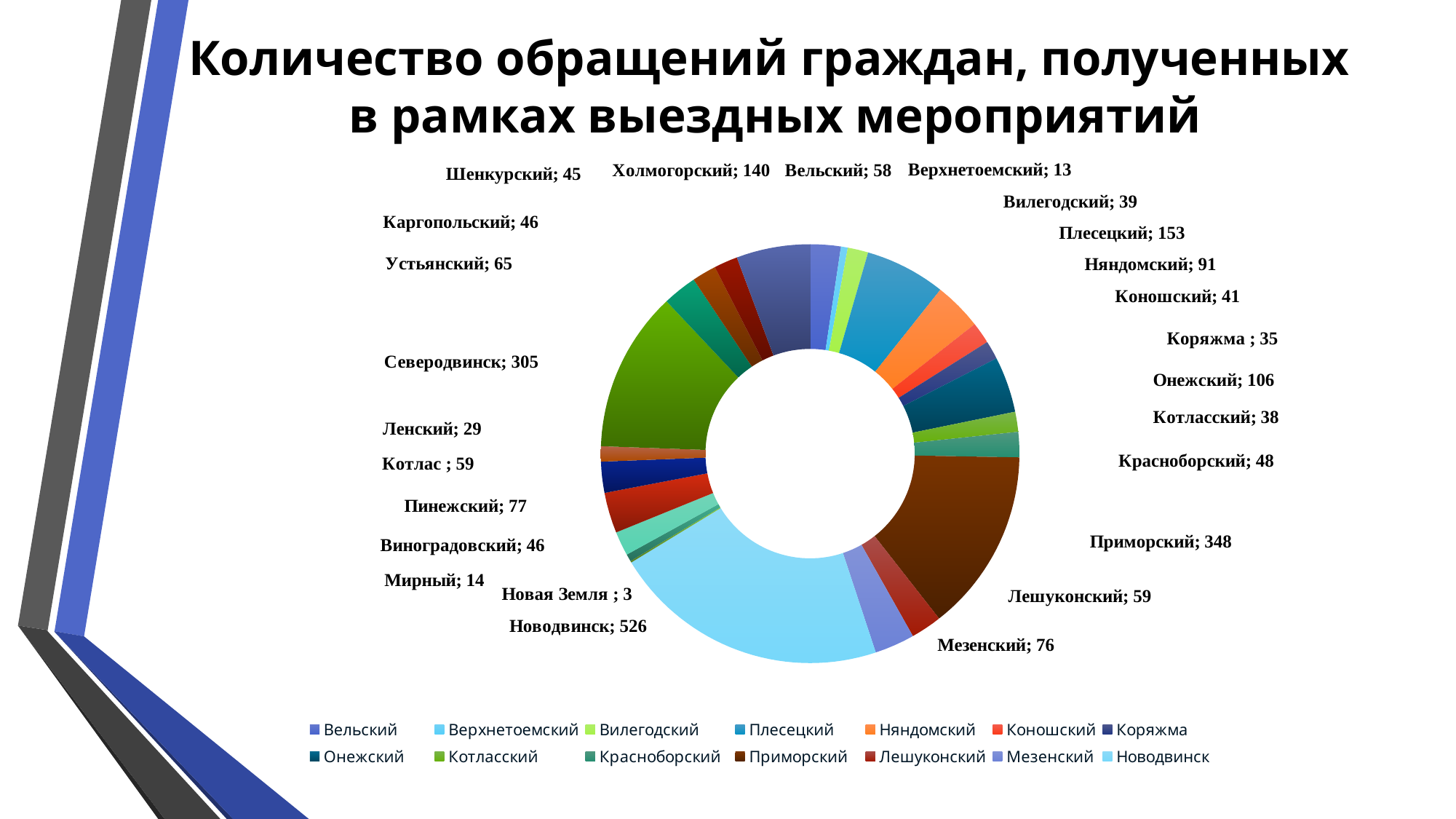
What type of chart is shown on the slide? Doughnut chart Which category has the highest number of appeals? Новодвинск Which is larger, the value for Онежский or the value for Няндомский? Онежский How many entries does the legend list? 14 What is the value for Новая Земля? 3 Which category has the lowest number of appeals? Новая Земля What is the value for Плесецкий? 153 What is the difference between the values for Плесецкий and Холмогорский? 13 How many citizen appeals are shown for Новодвинск? 526 What is the value for Приморский? 348 What is the difference between the values for Приморский and Северодвинск? 43 How many categories are labelled on the chart? 25